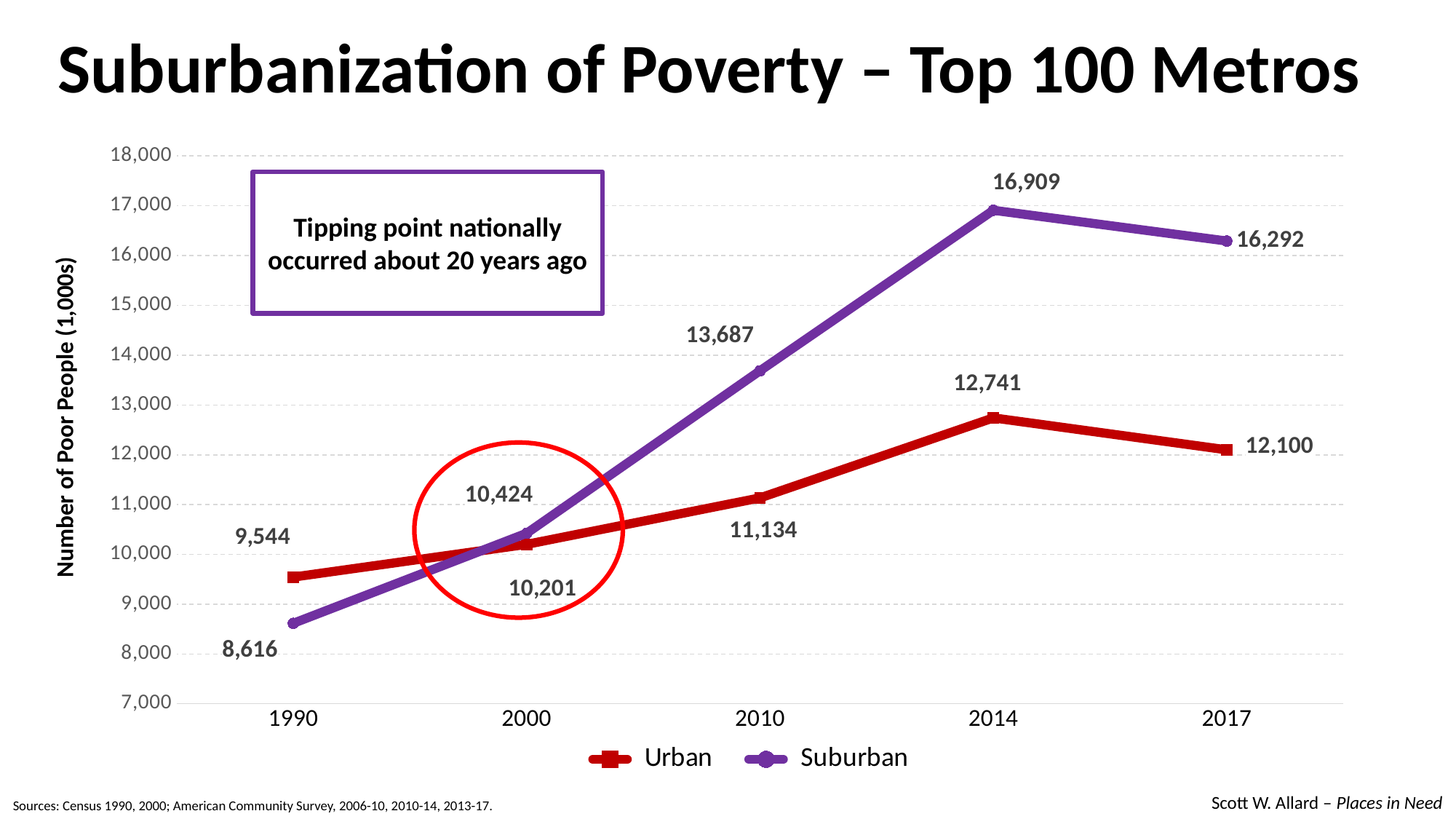
Which series has the larger value in 1990, Urban or Suburban? Urban What is the Suburban value in 2000? 10,424 What is the Urban value in 1990? 9,544 What is the Suburban value in 2014? 16,909 In which year is the Suburban series at its highest? 2014 How many years are plotted along the x axis? 5 How many series does the legend list? 2 In which year is the Suburban series at its lowest? 1990 What type of chart is shown on the slide? Line chart What is the Urban value in 2017? 12,100 What is the difference between the Suburban and Urban values in 2014? 4,168 What is the difference between the Suburban and Urban values in 2010? 2,553